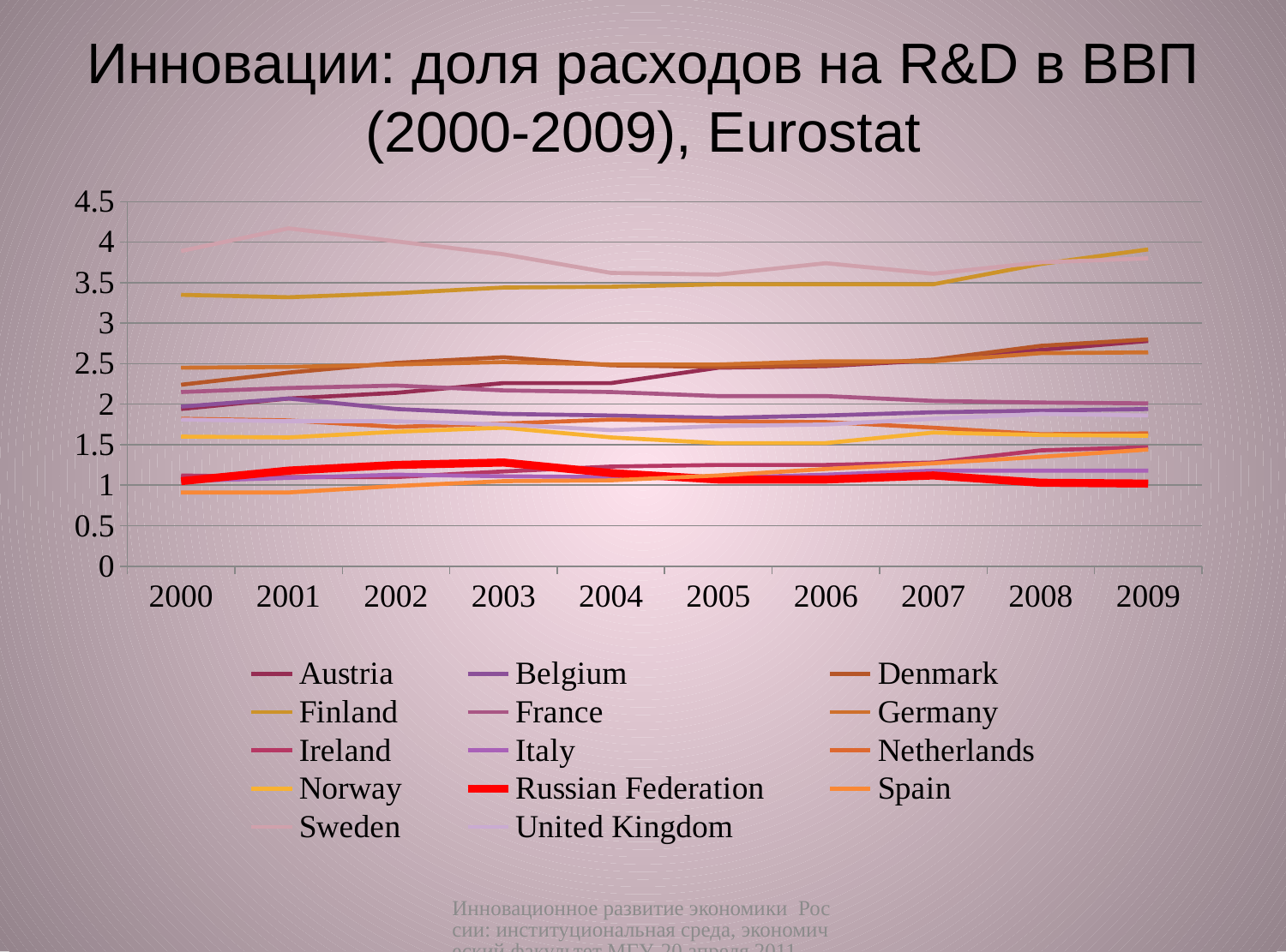
Is the value for Finland in 2000 greater or less than 3.5? less Which is larger in 2001, the value for Sweden or the value for Finland? Sweden Is the value for Spain in 2000 greater or less than 1? less What kind of chart is shown on the slide? line chart Is the value for Sweden in 2001 greater or less than 4? greater Which country has the highest value in 2001? Sweden Which country has the lowest value in 2000? Spain How many countries (series) does the legend list? 14 Does the value for Finland rise or fall from 2000 to 2009? rise How many years are shown along the x axis? 10 Which series is drawn with the thick red line? Russian Federation